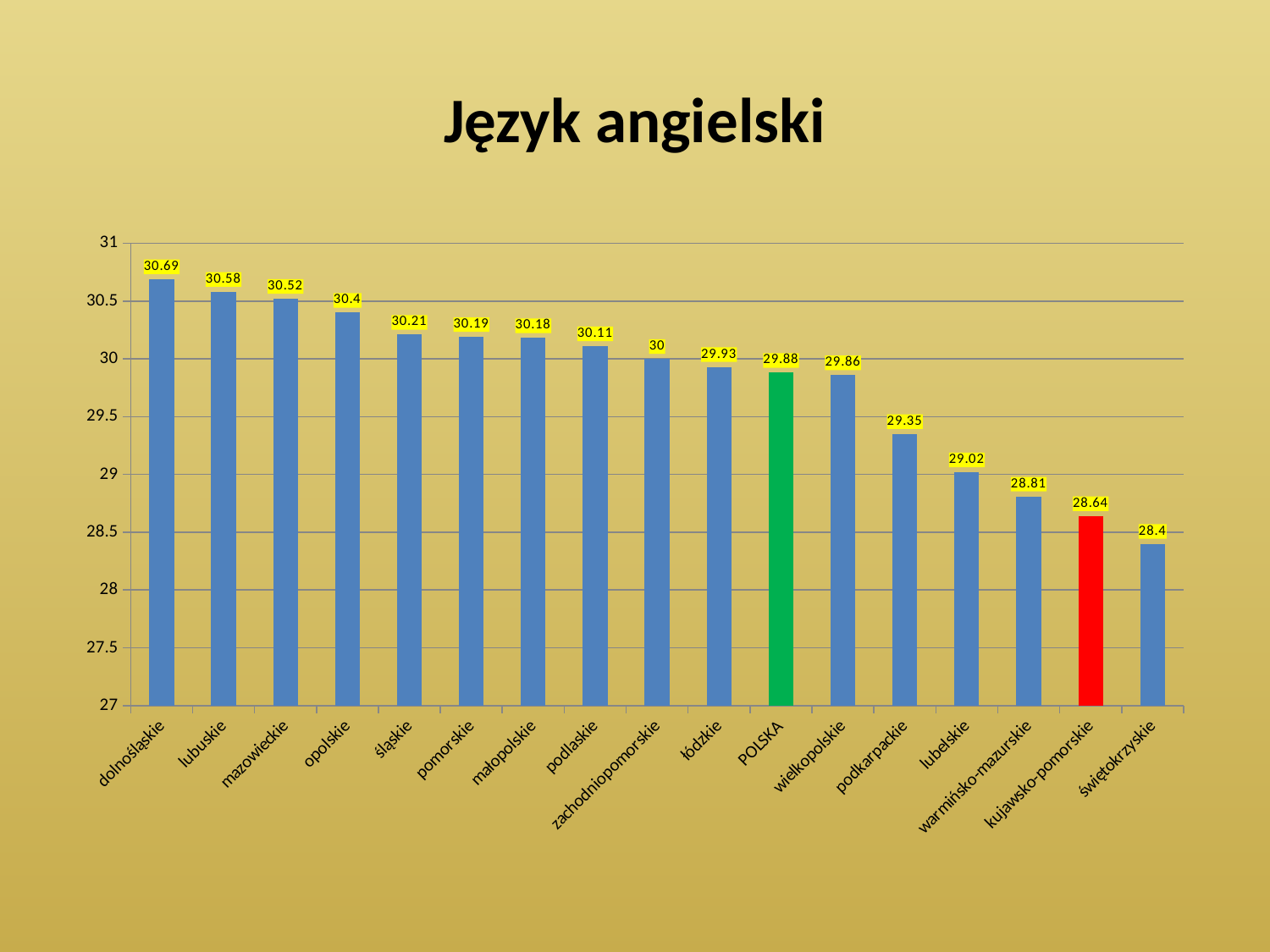
Which category has the highest value? dolnośląskie Which category has the lowest value? świętokrzyskie What is the value for zachodniopomorskie? 30 Which is larger, the value for podkarpackie or the value for lubelskie? podkarpackie What kind of chart is shown on the slide? bar chart How many bars are shown in the chart? 17 What is the difference between the values for dolnośląskie and świętokrzyskie? 2.29 What is the title of the chart? Język angielski Is the value for warmińsko-mazurskie greater or less than 29? less What is the value for dolnośląskie? 30.69 What is the value for kujawsko-pomorskie? 28.64 What is the value for POLSKA? 29.88